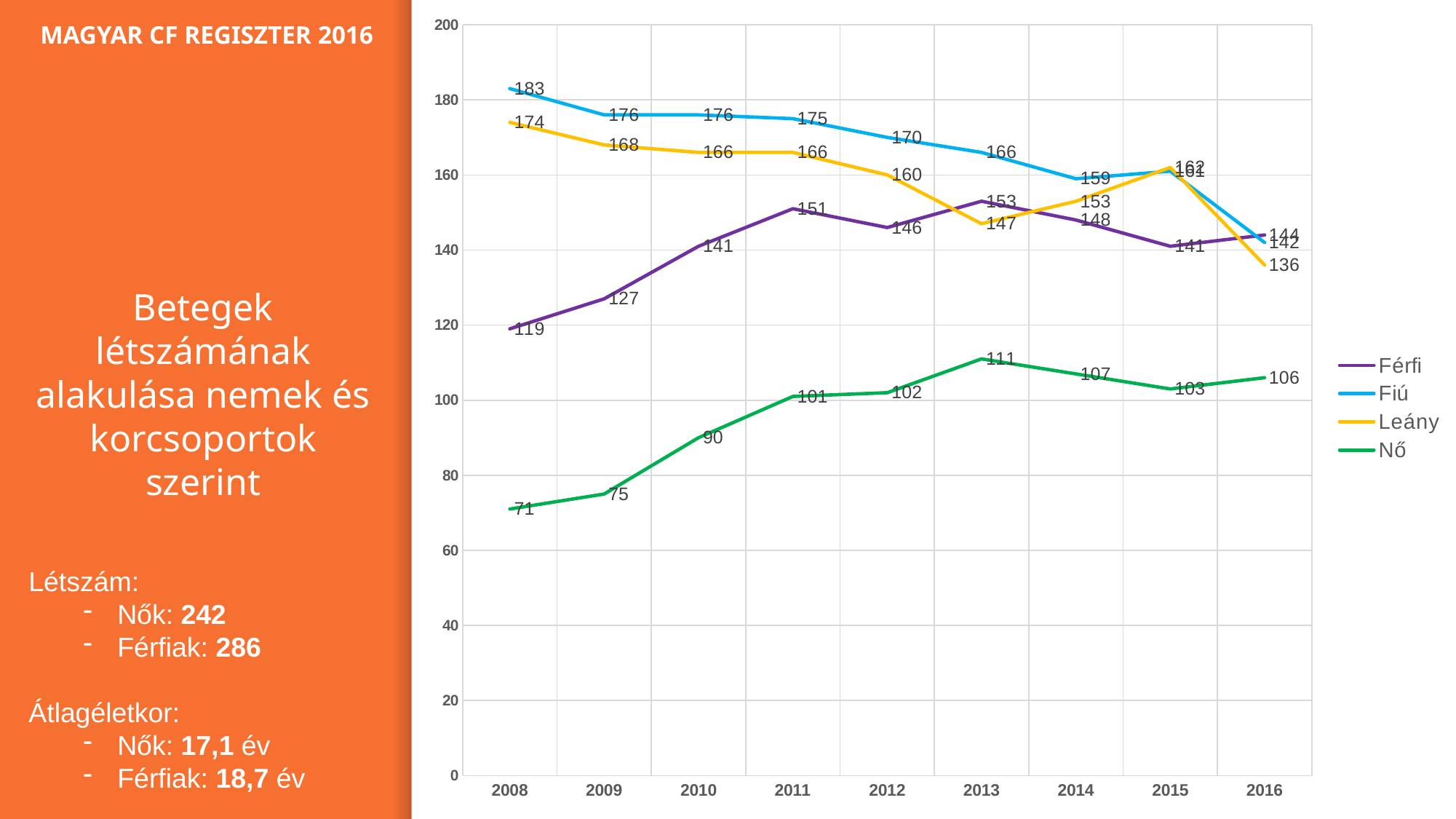
What is the value for Férfi in 2011? 151 In which year does the Nő series reach its highest value? 2013 What is the value for Nő in 2008? 71 What kind of chart is shown on the slide? line chart How many years are shown on the x axis? 9 What is the value for Leány in 2016? 136 Which is larger in 2013, the Férfi value or the Leány value? Férfi Does the Nő series rise or fall from 2008 to 2013? rise What is the value for Fiú in 2008? 183 How many series does the legend list? 4 What is the difference between the Fiú and Leány values in 2008? 9 In which year does the Férfi series have its lowest value? 2008